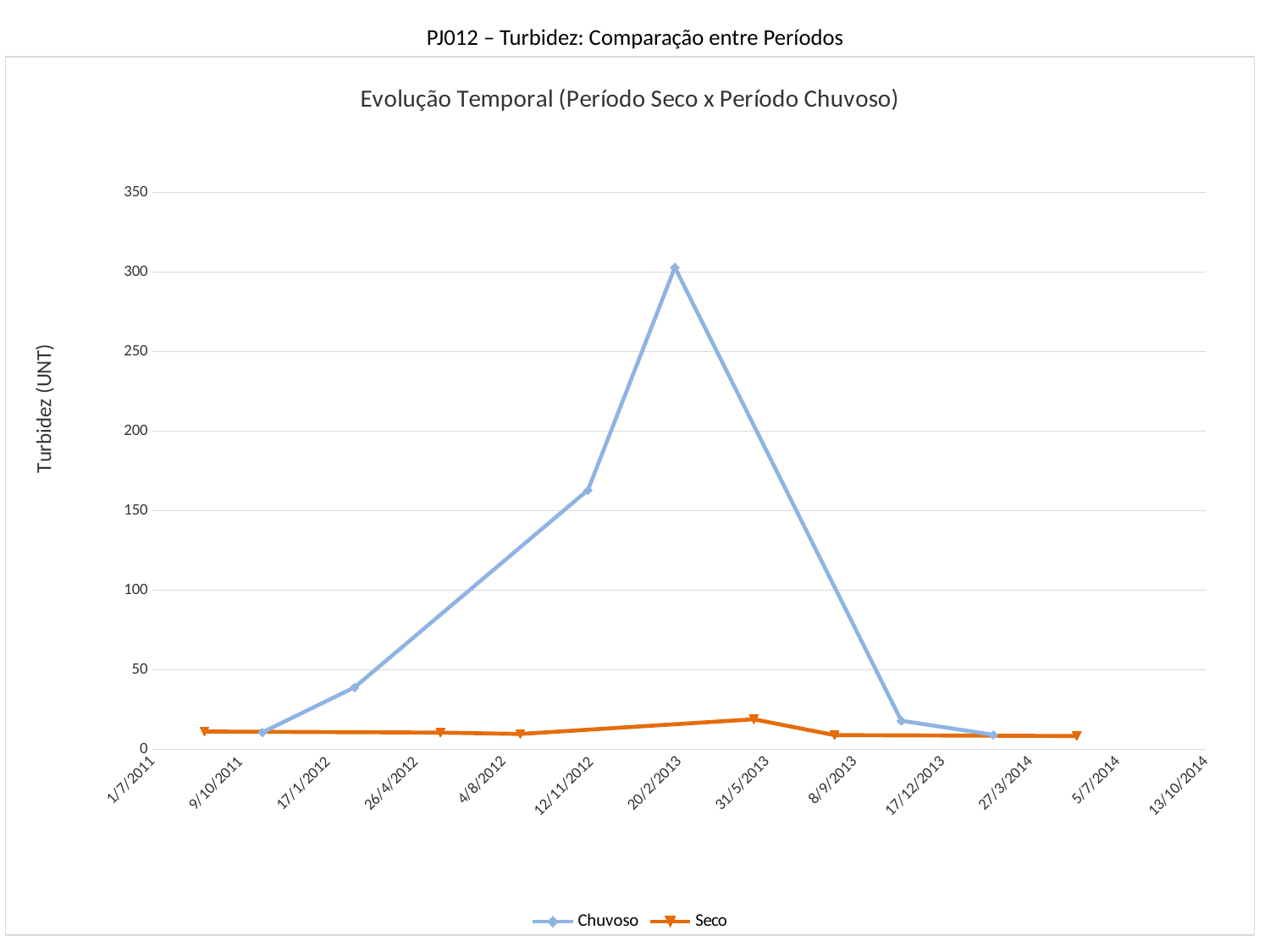
How many series does the legend list? 2 What is the label on the vertical axis? Turbidez (UNT) Is the peak value of the Chuvoso series greater or less than 250? greater Does the Chuvoso series rise or fall from its first point to its peak near 20/2/2013? rise Is the highest value of the Seco series greater or less than 50? less Does the Chuvoso series rise or fall from its peak near 20/2/2013 to its last point? fall Is the Chuvoso point near 12/11/2012 greater or less than 150? greater Which series reaches the highest value on the chart? Chuvoso What kind of chart is shown on the slide? line chart Around 20/2/2013, which series has the larger value, Chuvoso or Seco? Chuvoso What is the title of the chart? Evolução Temporal (Período Seco x Período Chuvoso)